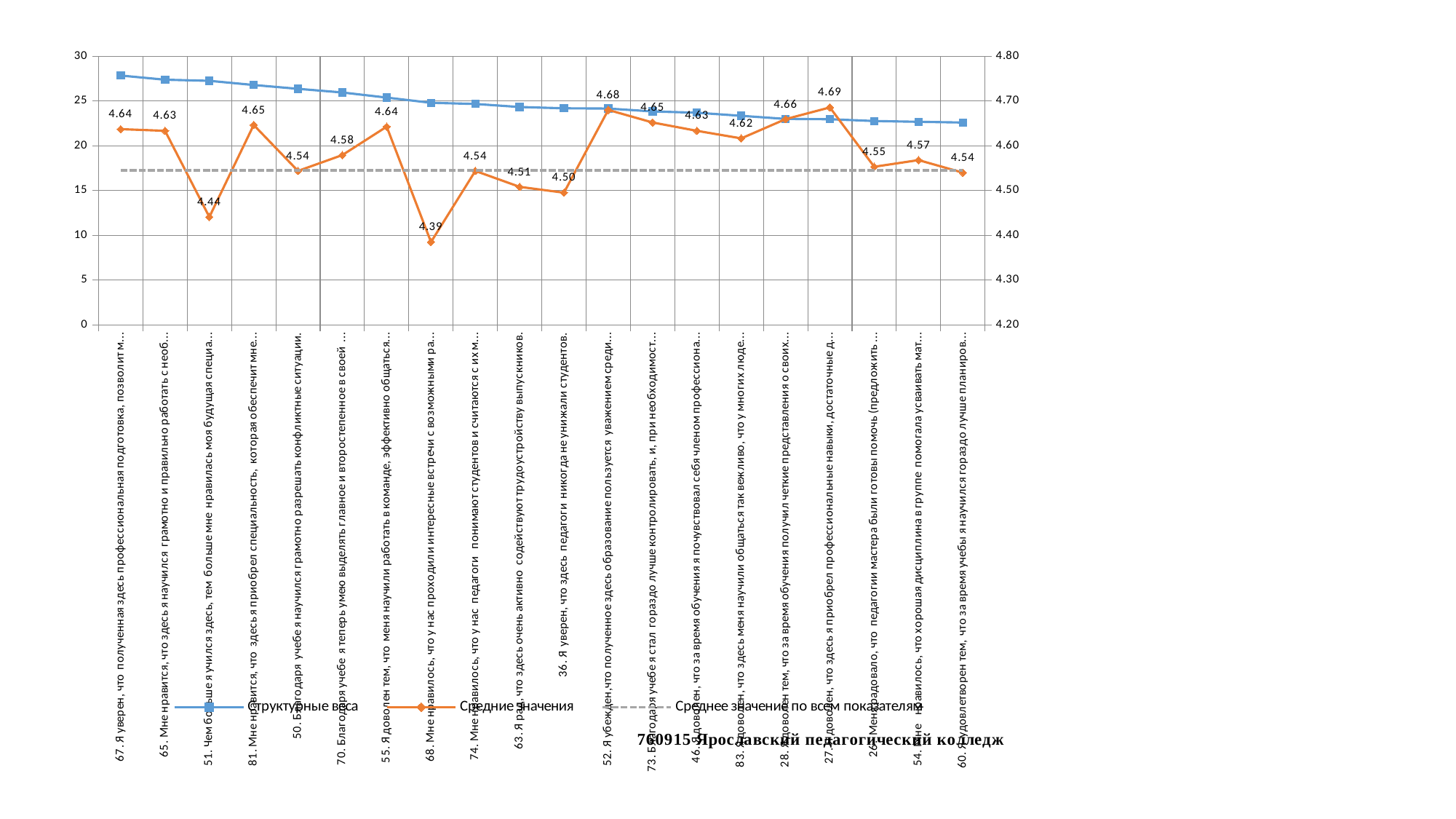
What is the value of 'Средние значения' for statement 68 ('Мне нравилось, что у нас проходили интересные встречи...')? 4.39 Which has a larger 'Средние значения' value: statement 81 or statement 50? statement 81 What type of chart is shown on the slide? line chart What is the value of 'Средние значения' for statement 27 ('Я доволен тем, что здесь я приобрел профессиональные навыки...')? 4.69 How many categories (statements) are plotted along the x axis? 20 Which statement has the highest 'Средние значения' value? 27. Я доволен, что здесь я приобрел профессиональные навыки, достаточные д... Does the 'Структурные веса' line rise or fall along the x axis? fall How many series does the legend list? 3 Which statement has the lowest 'Средние значения' value? 68. Мне нравилось, что у нас проходили интересные встречи с возможными ра... What is the value of 'Средние значения' for statement 51 ('Чем больше я учился здесь, тем больше мне нравилась моя будущая специа...')? 4.44 Is the 'Структурные веса' value for the first statement (67) greater or less than 25? greater What is the difference between the 'Средние значения' values for statement 52 (4.68) and statement 36 (4.50)? 0.18